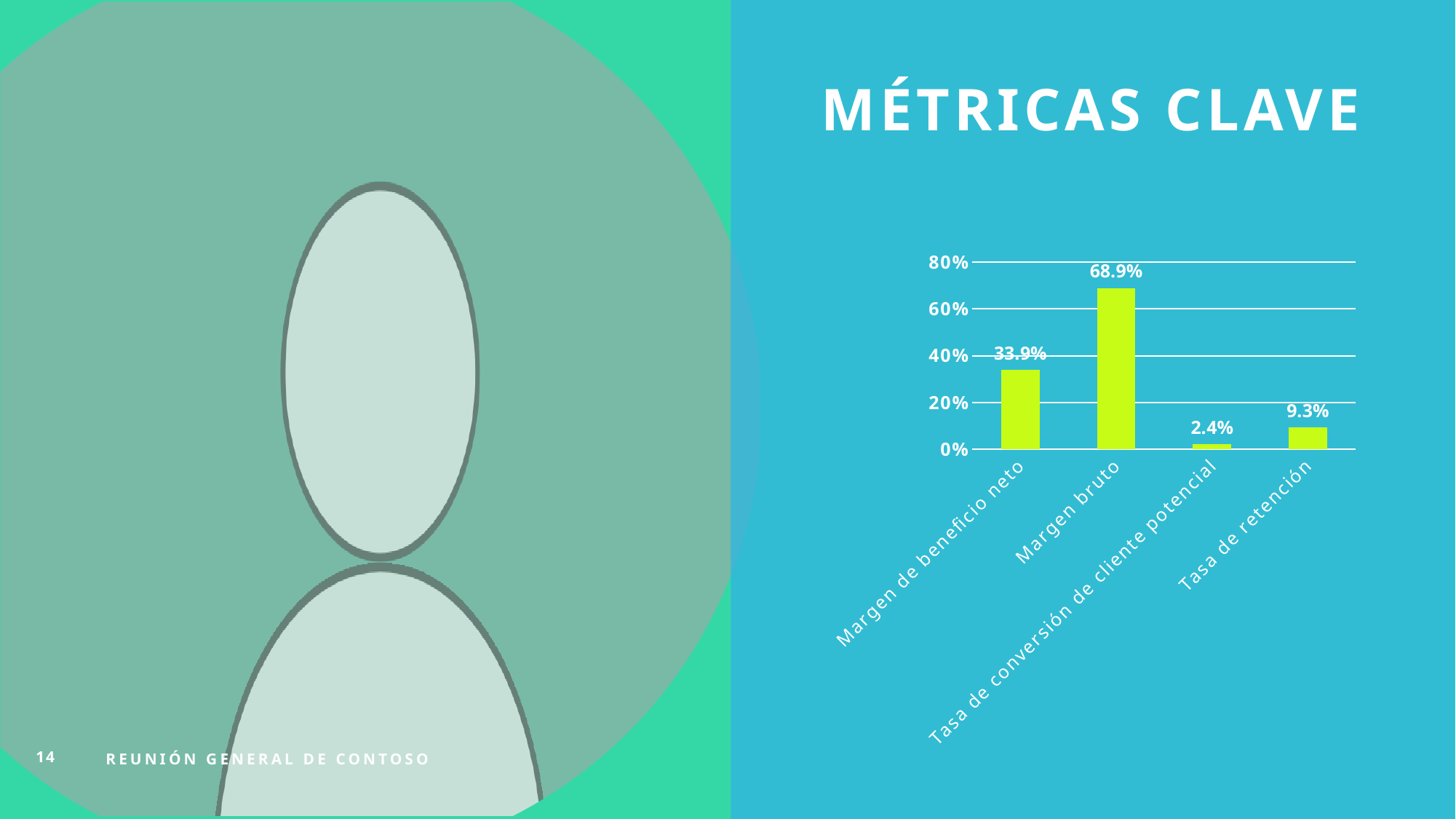
What is the value for Margen de beneficio neto? 33.9% What is the difference between Margen bruto and Margen de beneficio neto? 35.0% Is the value for Margen bruto greater or less than 60%? greater Which category has the highest value? Margen bruto Which category has the lowest value? Tasa de conversión de cliente potencial Which is larger, Tasa de retención or Tasa de conversión de cliente potencial? Tasa de retención What kind of chart is shown on the slide? Bar chart What is the value for Margen bruto? 68.9% What is the value for Tasa de conversión de cliente potencial? 2.4% What is the value for Tasa de retención? 9.3% What is the title of the slide containing the chart? MÉTRICAS CLAVE How many categories are shown in the chart? 4